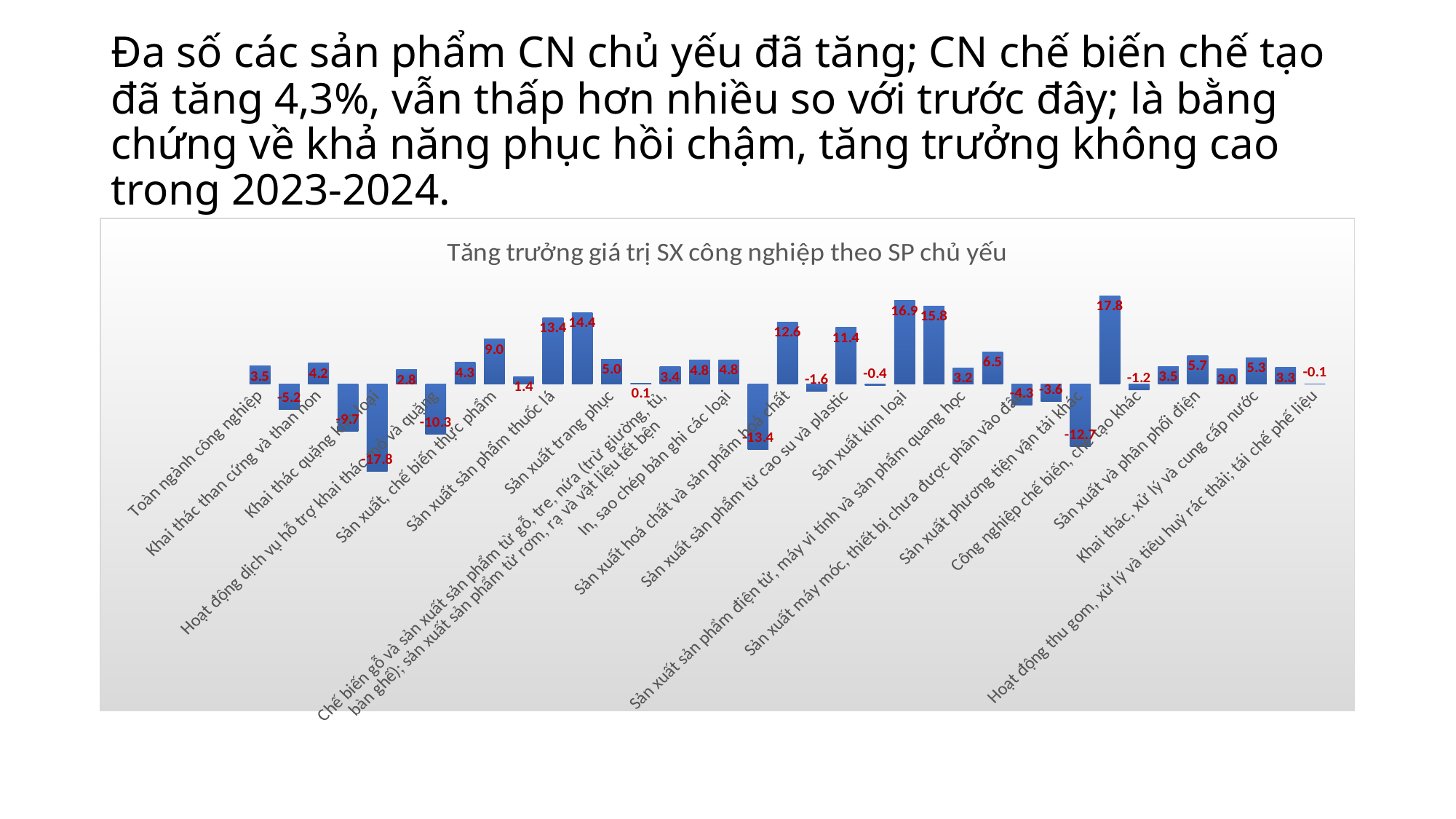
What is the value for Toàn ngành công nghiệp? 3.5 What is the highest value shown in the chart? 17.8 What is the value for Sản xuất phương tiện vận tải khác? -12.7 What is the value for Hoạt động thu gom, xử lý và tiêu huỷ rác thải; tái chế phế liệu? -0.1 What is the title of the chart? Tăng trưởng giá trị SX công nghiệp theo SP chủ yếu What is the value for Khai thác quặng kim loại? -17.8 What kind of chart is shown on the slide? bar chart What is the value for Sản xuất sản phẩm thuốc lá? 13.4 What is the value for Sản xuất kim loại? 16.9 Which labelled category has the lowest value? Khai thác quặng kim loại What is the difference between the values for Sản xuất kim loại and Sản xuất hoá chất và sản phẩm hoá chất? 4.3 Which is larger, the value for Sản xuất sản phẩm thuốc lá or the value for Sản xuất trang phục? Sản xuất sản phẩm thuốc lá